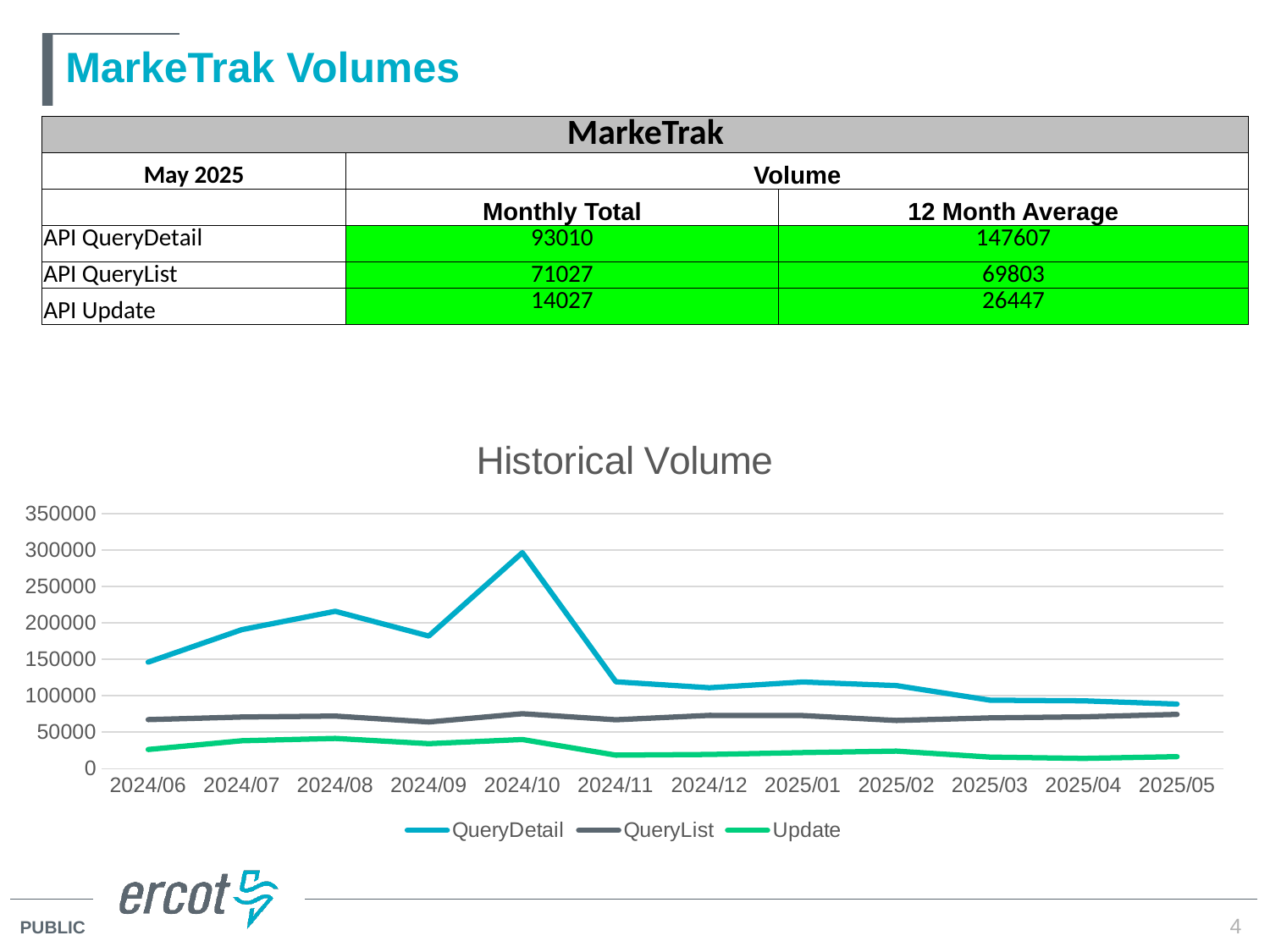
Which series has the lowest values across the whole Historical Volume chart? Update Does the QueryDetail series rise or fall between 2024/10 and 2024/11? fall At 2024/10, which series has the larger value, QueryDetail or QueryList? QueryDetail Is the QueryDetail value for 2024/06 greater or less than 100000? greater What kind of chart is the Historical Volume chart? line chart In which month does the QueryDetail series reach its highest value? 2024/10 How many months are plotted along the x axis of the Historical Volume chart? 12 Is the QueryList value for 2024/10 greater or less than 100000? less What is the title of the line chart on the slide? Historical Volume Is the Update value for 2025/05 greater or less than 50000? less How many series does the legend of the Historical Volume chart list? 3